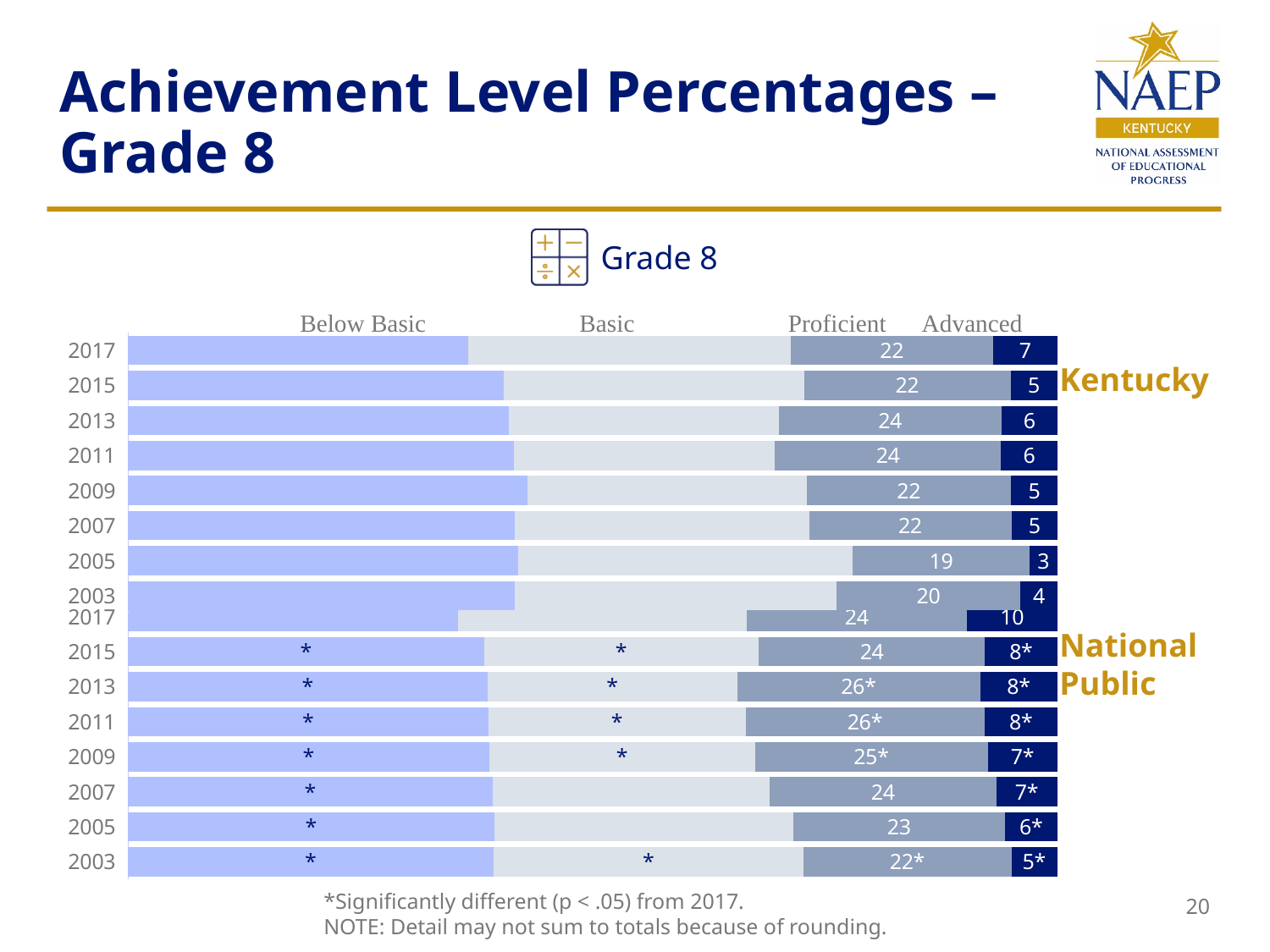
How much higher was Kentucky's Advanced percentage in 2017 than in 2005? 4 How many achievement levels are shown in the chart's legend? 4 How many years are shown for Kentucky in the chart? 8 What type of chart is used on this slide? Stacked bar chart In which year was Kentucky's Advanced percentage the highest? 2017 In which year was the National Public Advanced percentage the lowest? 2003 What percentage of Kentucky grade 8 students were at the Proficient level in 2017? 22 What is the Proficient value shown for National Public in 2013? 26* In which year was Kentucky's Proficient percentage the lowest? 2005 Which was larger in 2017: Kentucky's Advanced percentage or National Public's Advanced percentage? National Public What percentage of Kentucky grade 8 students were at the Advanced level in 2017? 7 What is the Advanced value shown for National Public in 2017? 10